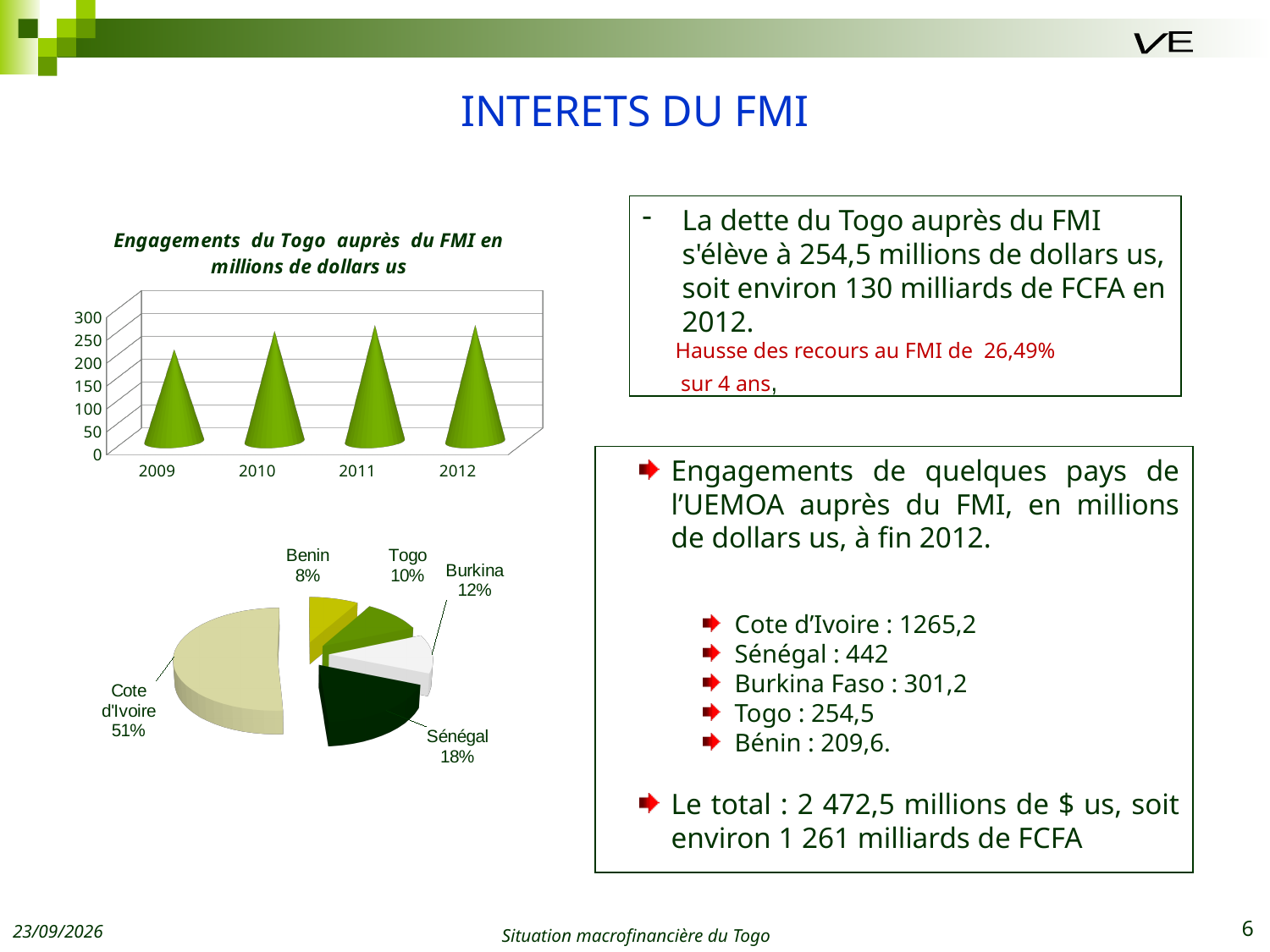
In the chart 'Engagements du Togo auprès du FMI en millions de dollars us', which year has the lowest value? 2009 In the bottom-left pie chart, how many slices are there? 5 In the bottom-left pie chart, what is the difference in percentage points between Cote d'Ivoire's share and Sénégal's share? 33 In the bottom-left pie chart, what share does Togo have? 10% In the chart 'Engagements du Togo auprès du FMI en millions de dollars us', how many years are shown on the x axis? 4 In the chart 'Engagements du Togo auprès du FMI en millions de dollars us', is the value for 2010 larger than the value for 2009? Yes What type of chart is the top-left chart titled 'Engagements du Togo auprès du FMI en millions de dollars us'? bar chart In the bottom-left pie chart, which country has the smallest slice? Benin In the bottom-left pie chart, what share does Cote d'Ivoire have? 51% What type of chart is the bottom-left chart showing Cote d'Ivoire, Sénégal, Burkina, Togo and Benin? pie chart In the chart 'Engagements du Togo auprès du FMI en millions de dollars us', is the value for 2009 greater or less than 150? greater In the chart 'Engagements du Togo auprès du FMI en millions de dollars us', is the value for 2012 greater or less than 200? greater